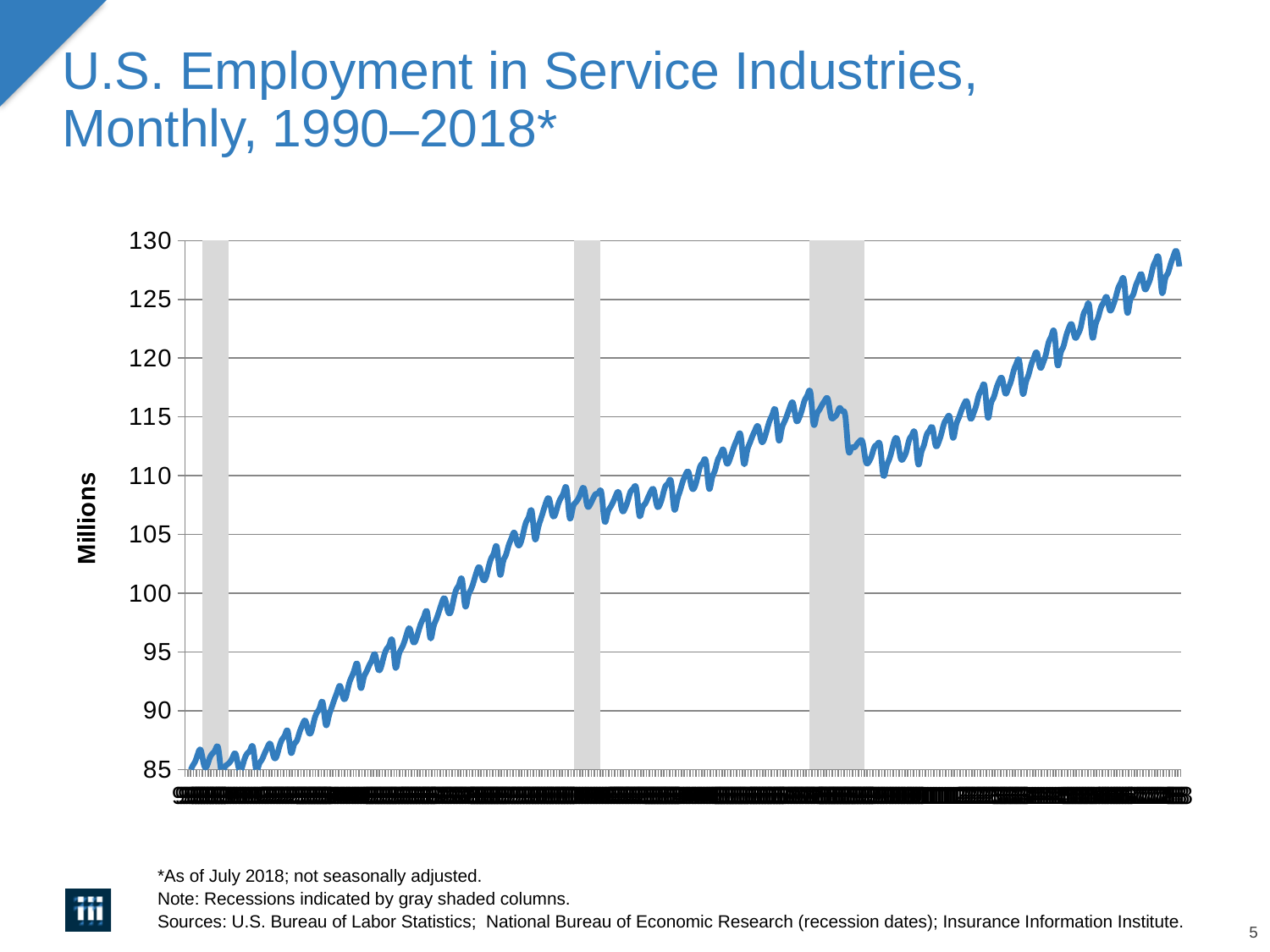
Is the value at the leftmost (earliest) point of the line greater or less than 90? less What is the title of the chart on the slide? U.S. Employment in Service Industries, Monthly, 1990–2018* How many gray shaded recession columns are shown on the chart? 3 What kind of chart is shown on the slide? line chart Is the value at the rightmost point of the line greater or less than 130? less Overall, do the values rise or fall from left to right along the x axis? rise Is the peak of the line just before the third gray shaded column greater or less than 115? greater